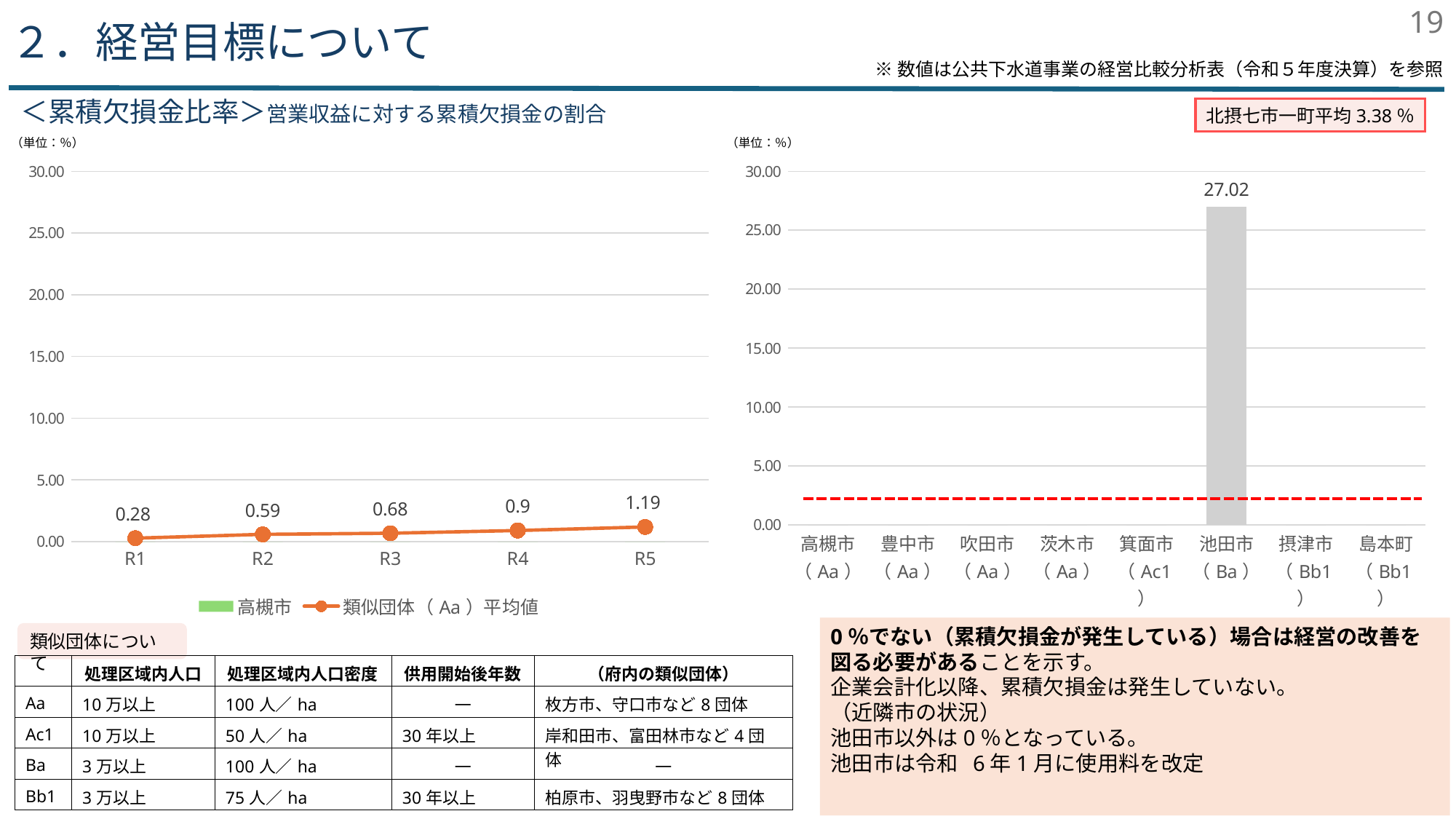
What kind of chart is the right chart? bar chart On the right chart, how many municipalities are listed on the x axis? 8 On the left chart, what is the difference between the R5 and R1 values of 類似団体（Aa）平均値? 0.91 On the right chart, which municipality has the highest value? 池田市 On the right chart, what is the value for 池田市（Ba）? 27.02 On the left chart, what is the value of 類似団体（Aa）平均値 for R1? 0.28 On the left chart, how many years (points) are plotted along the x axis? 5 On the left chart, does the 類似団体（Aa）平均値 line rise or fall from R1 to R5? rise On the left chart, which year has the highest value for 類似団体（Aa）平均値? R5 On the left chart, how many series does the legend list? 2 On the left chart, what is the value of 類似団体（Aa）平均値 for R5? 1.19 On the left chart, what is the value of 類似団体（Aa）平均値 for R3? 0.68